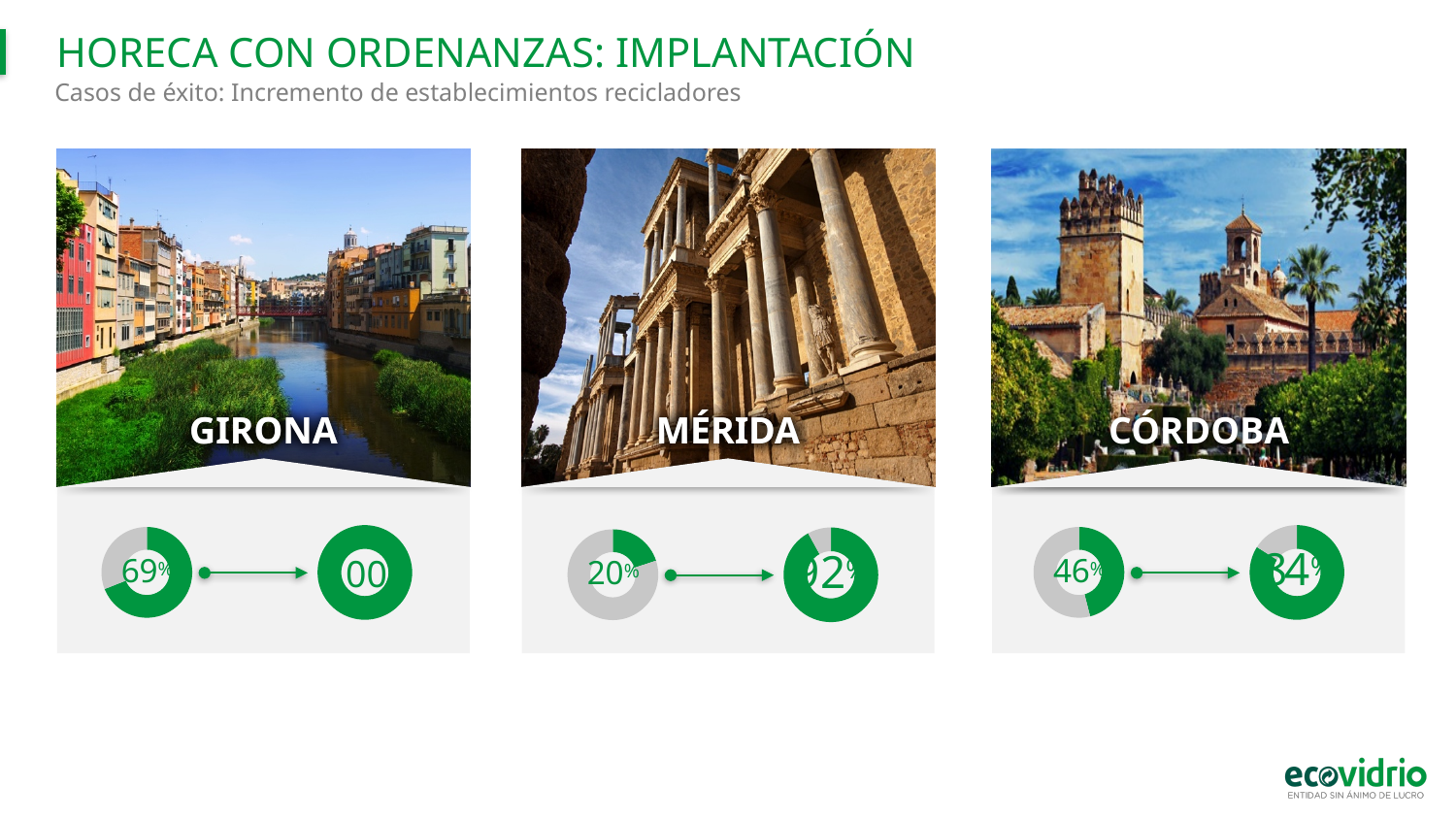
What is the main title of the slide? HORECA CON ORDENANZAS: IMPLANTACIÓN Which starting percentage is larger, Córdoba's or Mérida's? Córdoba's How many cities are shown with charts on the slide? 3 Which city has the highest starting percentage in its left donut? Girona Which city has the lowest starting percentage in its left donut? Mérida On the Córdoba chart, what is the starting percentage shown in the left donut? 46% What is the difference between the starting percentages of Girona and Mérida? 49 percentage points What is the difference between the starting percentages of Girona and Córdoba? 23 percentage points On the Girona chart, what is the starting percentage shown in the left donut? 69% Which starting percentage is larger, Girona's or Córdoba's? Girona's On the Mérida chart, what is the starting percentage shown in the left donut? 20% What kind of chart is used to show the percentages for each city? Donut chart